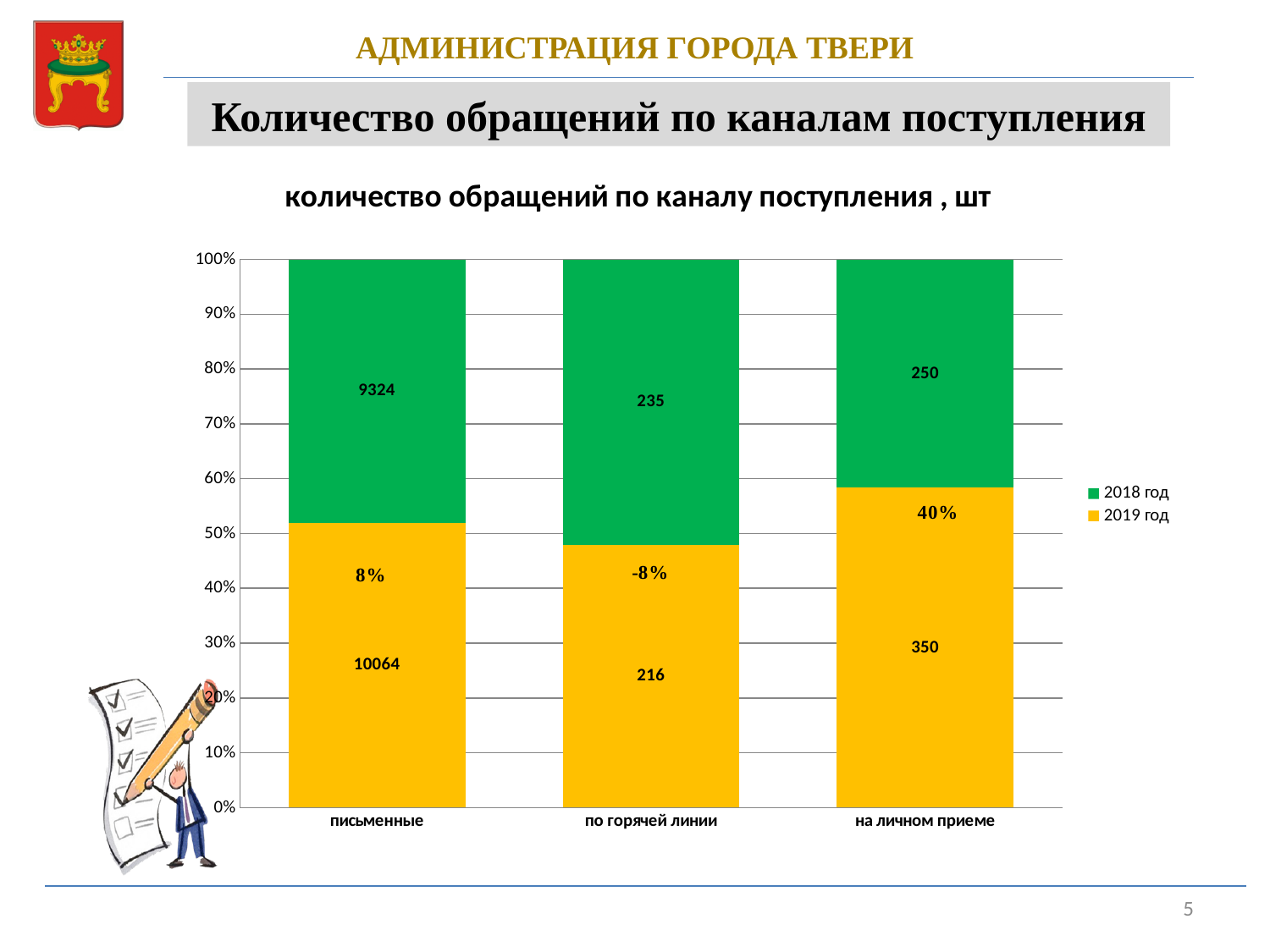
Which category has the lowest value for 2019 год? по горячей линии What is the value for 2018 год for the письменные category? 9324 How many series does the legend list? 2 What is the difference between the 2019 год and 2018 год values for the на личном приеме category? 100 What is the value for 2019 год for the письменные category? 10064 What percentage change label is shown on the на личном приеме bar? 40% Which category has the highest value for 2019 год? письменные What is the value for 2018 год for the по горячей линии category? 235 How many categories are shown on the x axis? 3 What is the value for 2019 год for the на личном приеме category? 350 What kind of chart is shown on the slide? stacked bar chart For the по горячей линии category, which is larger: the 2018 год value or the 2019 год value? 2018 год